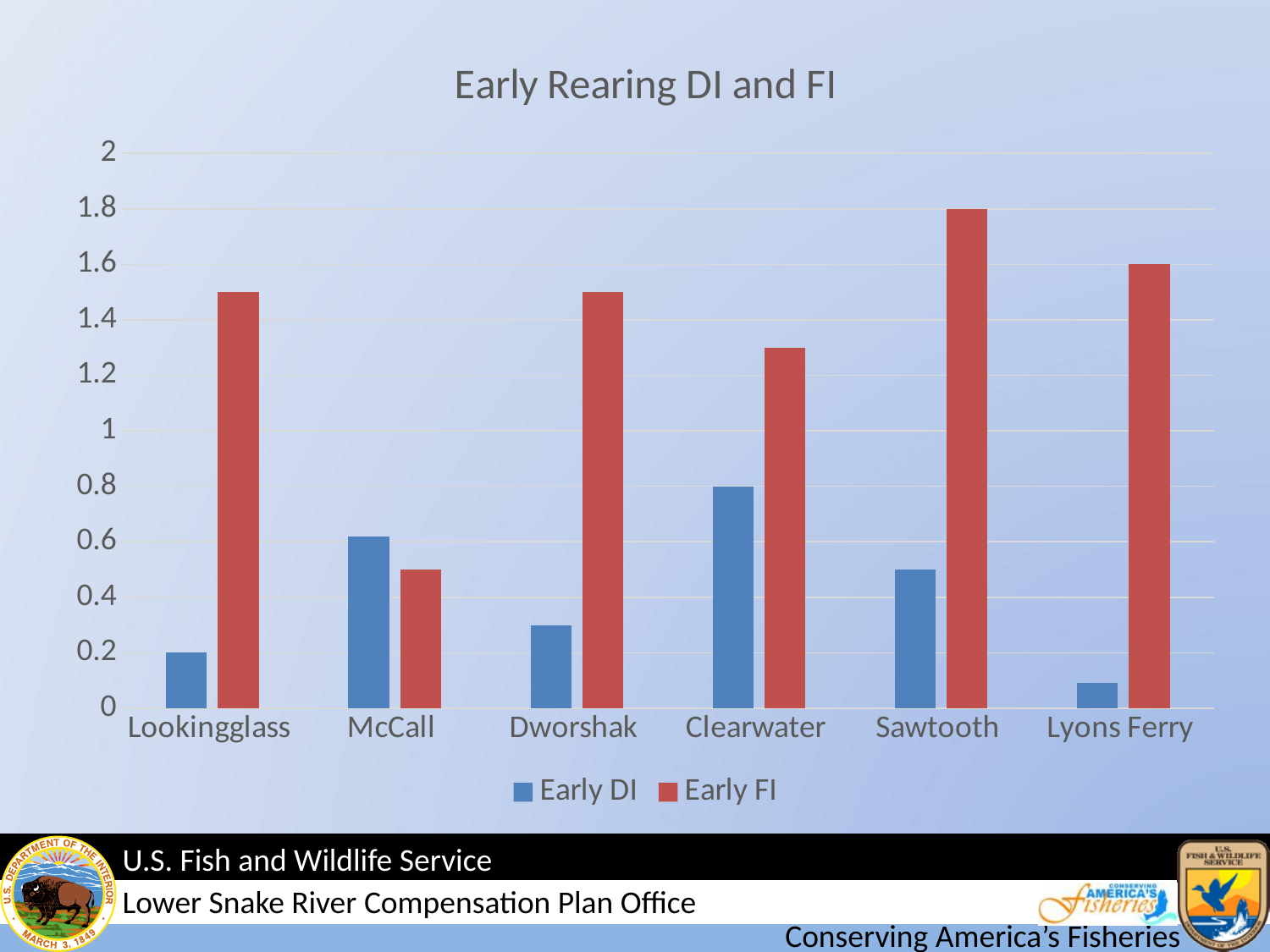
How many hatcheries (categories) are shown on the x axis? 6 What is the Early FI value for Sawtooth? 1.8 What type of chart is shown on the slide? bar chart What is the Early DI value for Lookingglass? 0.2 What is the Early FI value for Lyons Ferry? 1.6 Which hatchery has the lowest Early DI value? Lyons Ferry Is the Early FI value for Lookingglass greater or less than 1.4? greater Which is larger for McCall, Early DI or Early FI? Early DI What is the title of the chart? Early Rearing DI and FI What is the Early DI value for Clearwater? 0.8 Which hatchery has the highest Early FI value? Sawtooth How many series does the legend list? 2